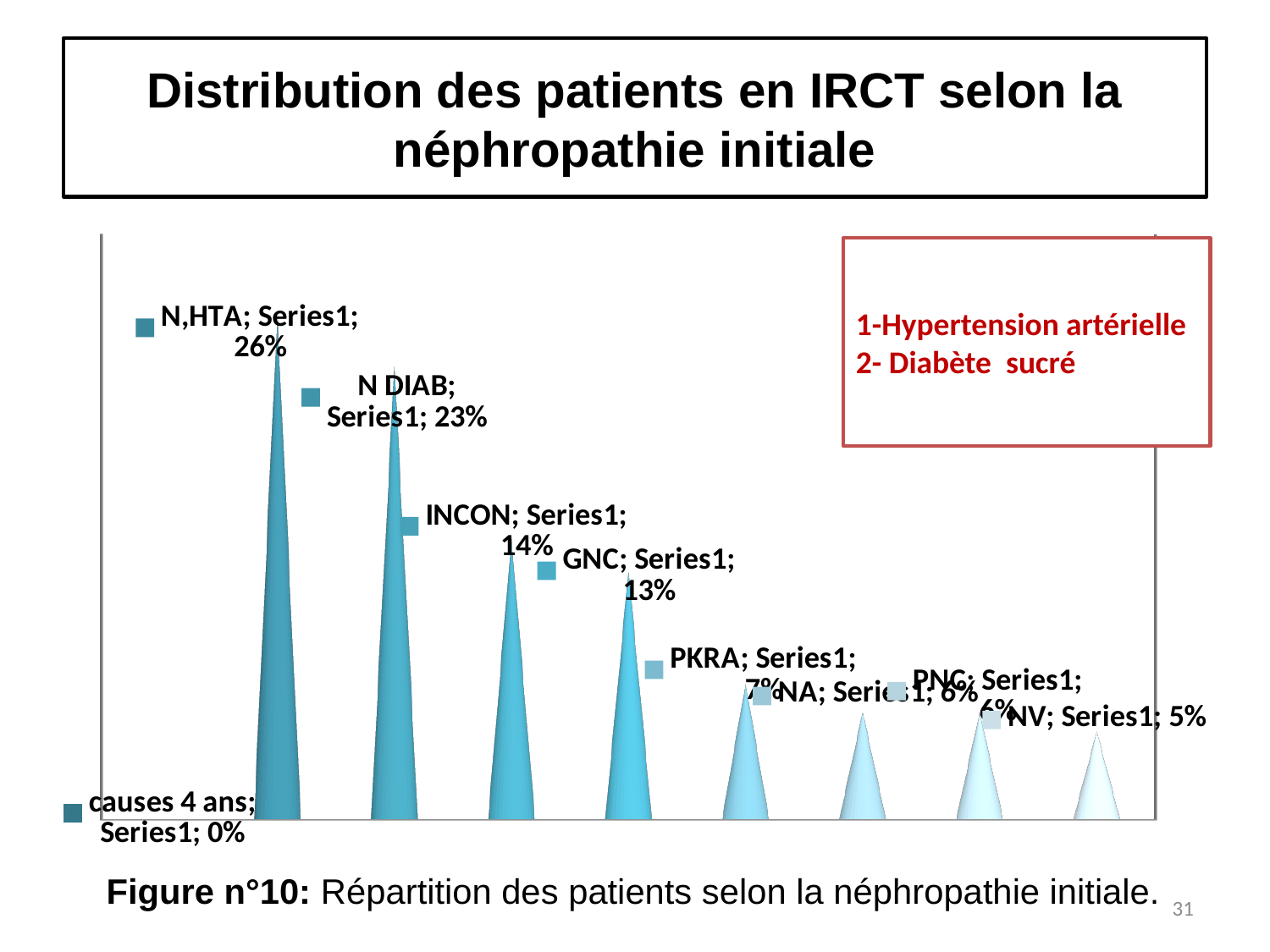
What is the difference between the values for N,HTA and N DIAB? 3% What is the value for N DIAB? 23% What is the value for N,HTA? 26% What is the difference between the values for GNC and NV? 8% Which is larger, the value for INCON or the value for PKRA? INCON What is the value for GNC? 13% What is the value for INCON? 14% Do the values rise or fall from left to right across the categories from N,HTA to NV? fall Which category has the highest value? N,HTA What is the value for PKRA? 7% What is the title of the slide containing the chart? Distribution des patients en IRCT selon la néphropathie initiale What is the value for NV? 5%